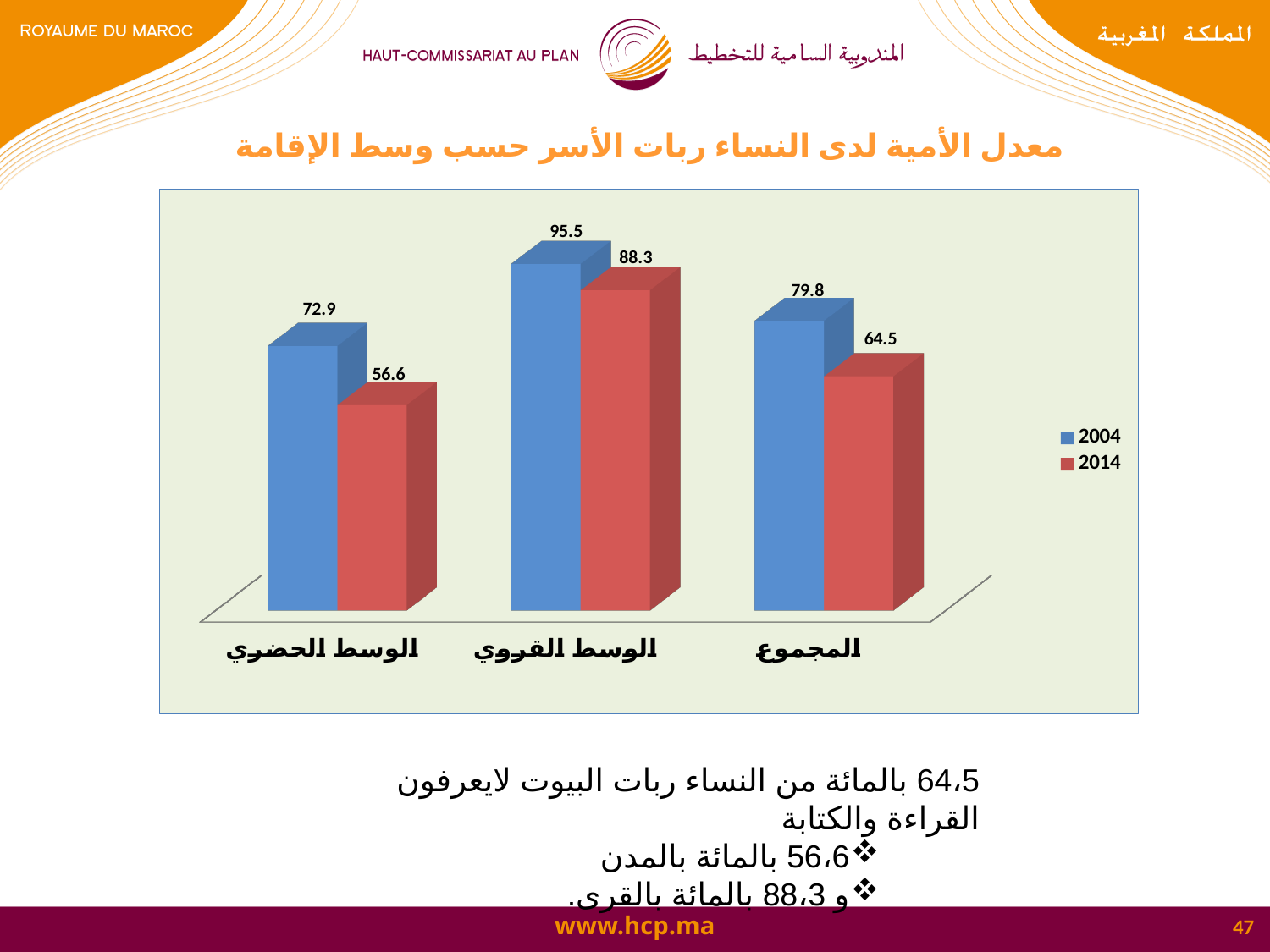
What kind of chart is shown on the slide? Bar chart What is the difference between the 2004 and 2014 values for الوسط الحضري? 16.3 Which category has the lowest value in the 2014 series? الوسط الحضري Which category has the highest value in the 2004 series? الوسط القروي Which series is shown in red in the legend? 2014 What is the value for الوسط الحضري in the 2004 series? 72.9 Which is larger: the 2014 value for الوسط القروي or the 2004 value for المجموع? The 2014 value for الوسط القروي How many series does the legend list? 2 What is the difference between the 2004 and 2014 values for المجموع? 15.3 How many categories are shown on the x axis? 3 What is the value for الوسط القروي in the 2014 series? 88.3 What is the value for المجموع in the 2014 series? 64.5